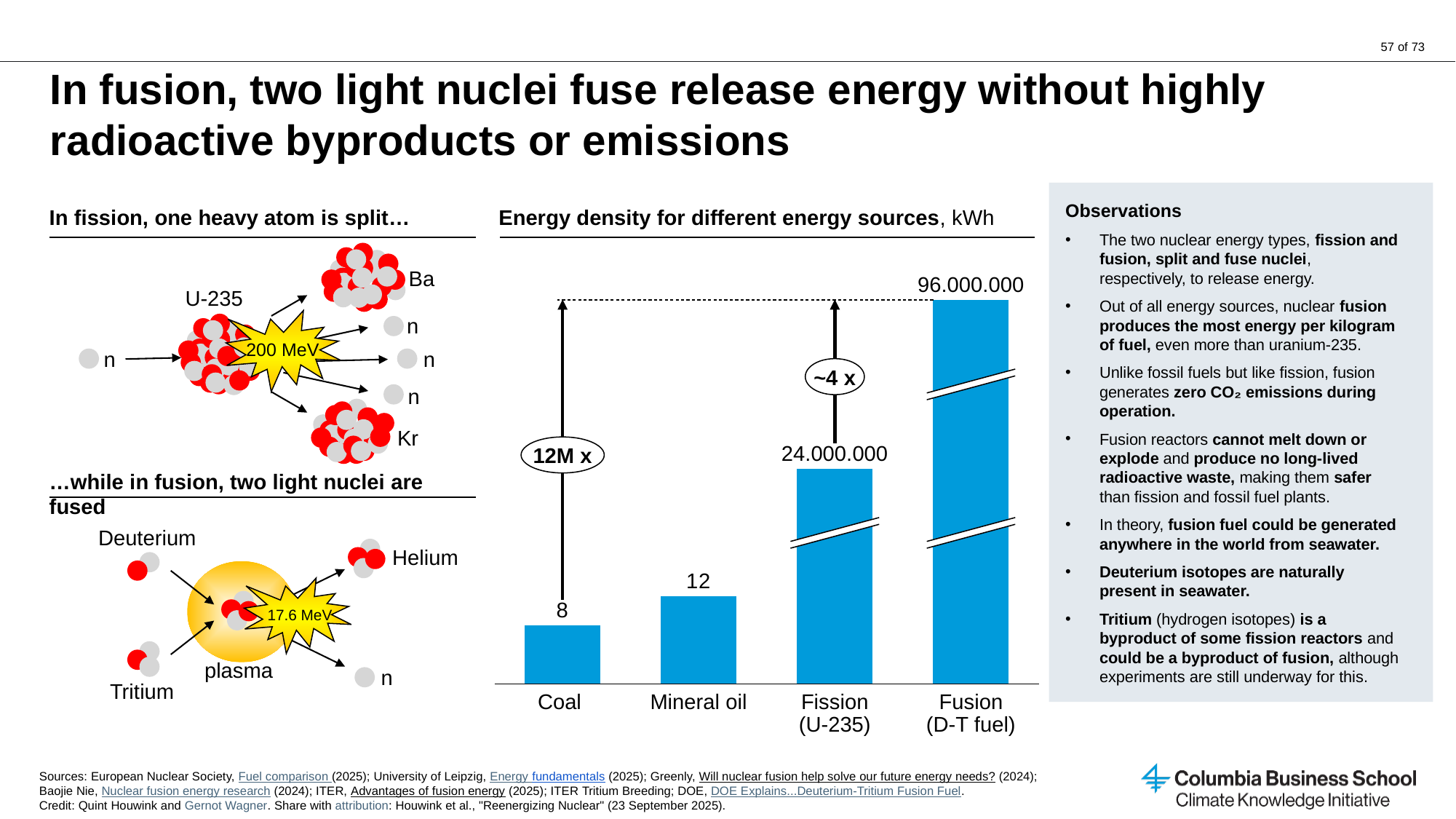
What is the energy density value shown for Fission (U-235)? 24.000.000 What is the energy density value shown for Coal? 8 What is the difference in energy density between Fusion (D-T fuel) and Fission (U-235)? 72.000.000 What is the energy density value shown for Fusion (D-T fuel)? 96.000.000 How many energy sources are shown in the chart? 4 Which energy source has the highest energy density in the chart? Fusion (D-T fuel) What is the energy density value shown for Mineral oil? 12 Which has a higher energy density, Fission (U-235) or Mineral oil? Fission (U-235) What unit is given in the chart title for energy density? kWh What type of chart is used to show energy density for different energy sources? Bar chart Which energy source has the lowest energy density in the chart? Coal What is the difference in energy density between Mineral oil and Coal? 4